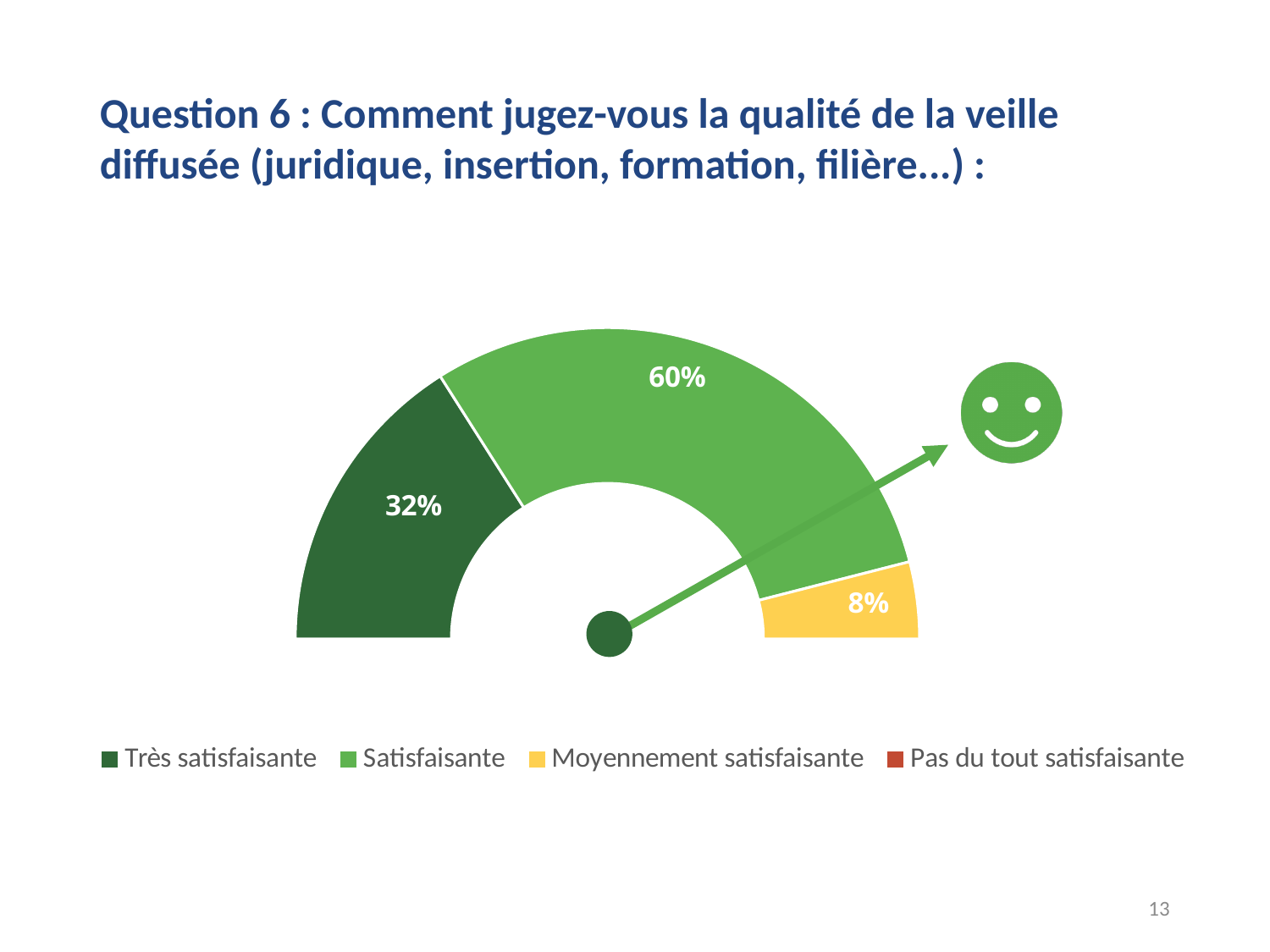
What is the difference in percentage points between "Très satisfaisante" and "Moyennement satisfaisante"? 24 What percentage of respondents rated the quality of the veille as "Satisfaisante"? 60% What is the combined share of "Très satisfaisante" and "Satisfaisante"? 92% Among the categories with a visible segment, which has the smallest share? Moyennement satisfaisante Which response category has the largest share? Satisfaisante What is the difference in percentage points between "Satisfaisante" and "Très satisfaisante"? 28 Which colour represents "Moyennement satisfaisante" in the chart? Yellow What percentage of respondents rated the quality as "Très satisfaisante"? 32% How many categories does the legend list? 4 What kind of chart is shown on the slide? A gauge (half-doughnut) chart What percentage of respondents rated the quality as "Moyennement satisfaisante"? 8% Which is larger: the share for "Très satisfaisante" or the share for "Moyennement satisfaisante"? Très satisfaisante